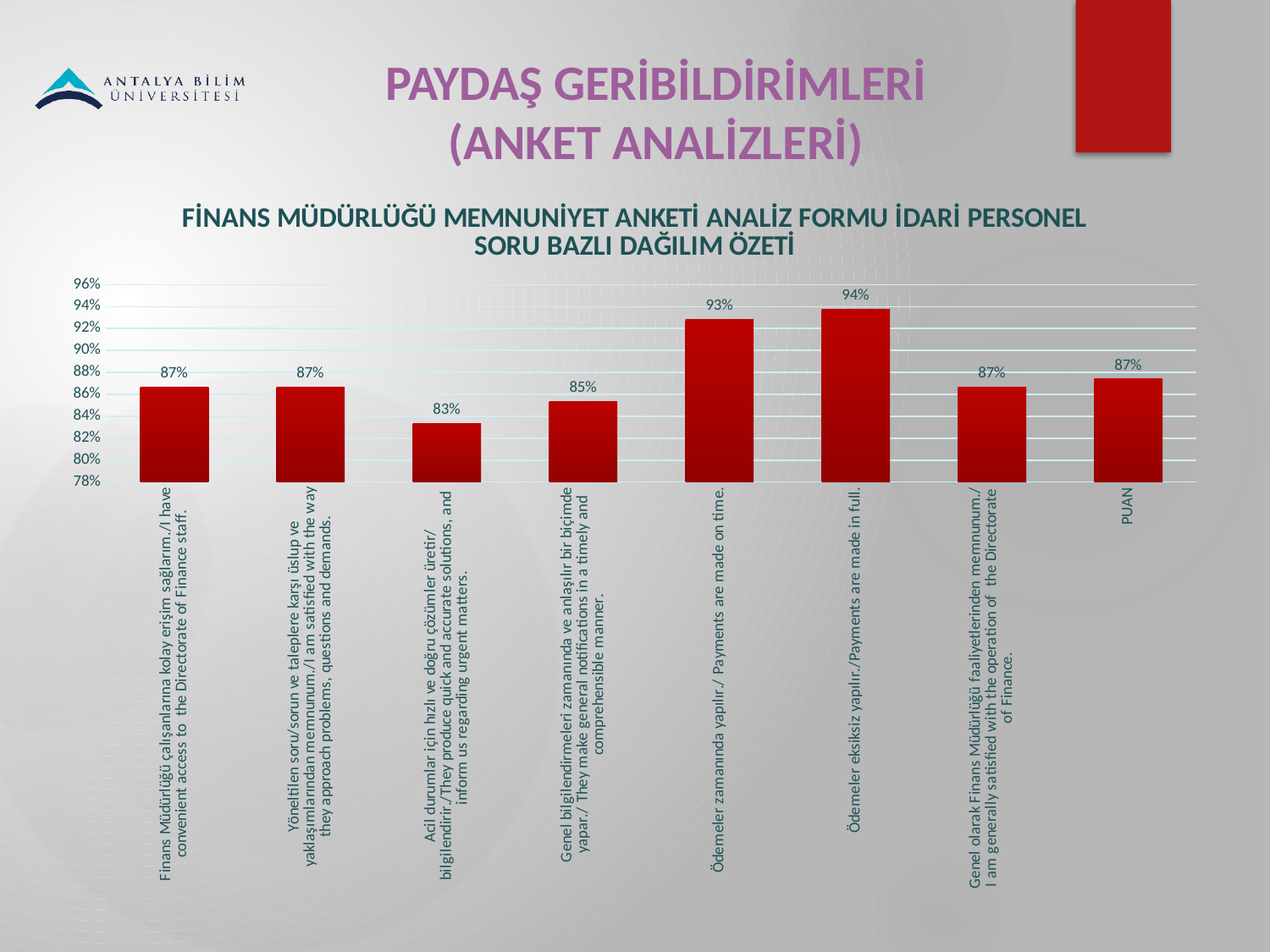
Which category has the highest value? Ödemeler eksiksiz yapılır./Payments are made in full. What is the value for "Ödemeler eksiksiz yapılır./Payments are made in full."? 94% Is the value for "Genel bilgilendirmeleri zamanında ve anlaşılır bir biçimde yapar" greater or less than 90%? less Which is larger: the value for "Payments are made on time" or the value for "Genel bilgilendirmeleri zamanında ve anlaşılır bir biçimde yapar" (general notifications)? Payments are made on time What is the value for "Acil durumlar için hızlı ve doğru çözümler üretir" (They produce quick and accurate solutions)? 83% What is the title of the chart? FİNANS MÜDÜRLÜĞÜ MEMNUNİYET ANKETİ ANALİZ FORMU İDARİ PERSONEL SORU BAZLI DAĞILIM ÖZETİ What is the value for PUAN? 87% Which category has the lowest value? Acil durumlar için hızlı ve doğru çözümler üretir/bilgilendirir./They produce quick and accurate solutions, and inform us regarding urgent matters. What kind of chart is shown on the slide? bar chart What is the value for "Ödemeler zamanında yapılır./ Payments are made on time."? 93% What is the difference between the value for "Payments are made in full" and the value for "They produce quick and accurate solutions"? 11% How many bars (categories) does the chart show? 8